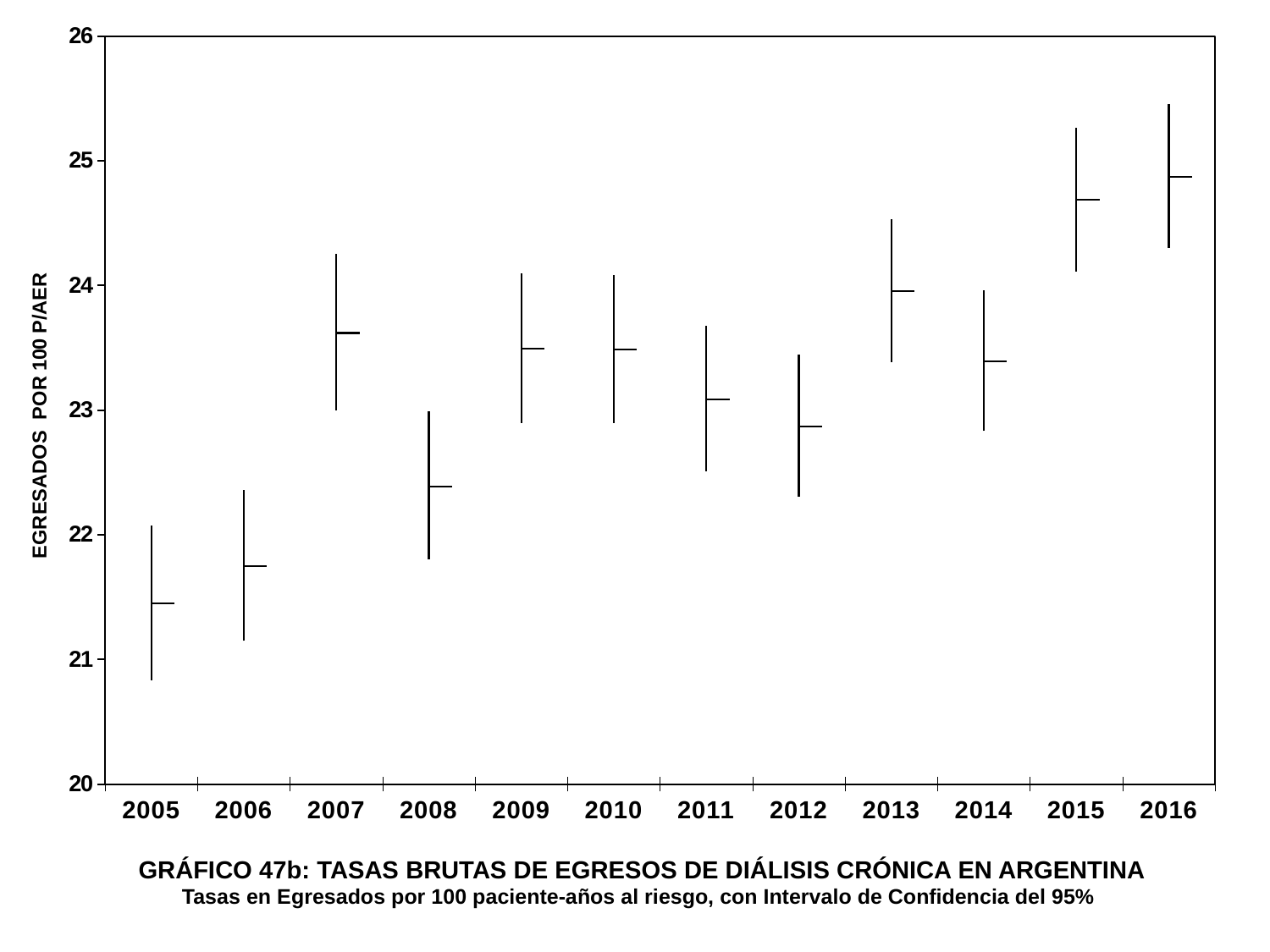
Which year has the lowest rate of egresados por 100 P/AER? 2005 How many years are plotted on the x axis? 12 Which year has the higher rate, 2013 or 2014? 2013 Is the rate for 2015 greater or less than 24? greater Which year has the highest rate of egresados por 100 P/AER? 2016 Overall, do the rates rise or fall from 2005 to 2016? rise Is the rate for 2012 greater or less than 23? less Which year has the higher rate, 2007 or 2008? 2007 Is the rate for 2007 greater or less than 23? greater What is the label on the y axis? EGRESADOS POR 100 P/AER What kind of chart is shown on the slide? A high-low-close (stock) chart showing rates with confidence intervals